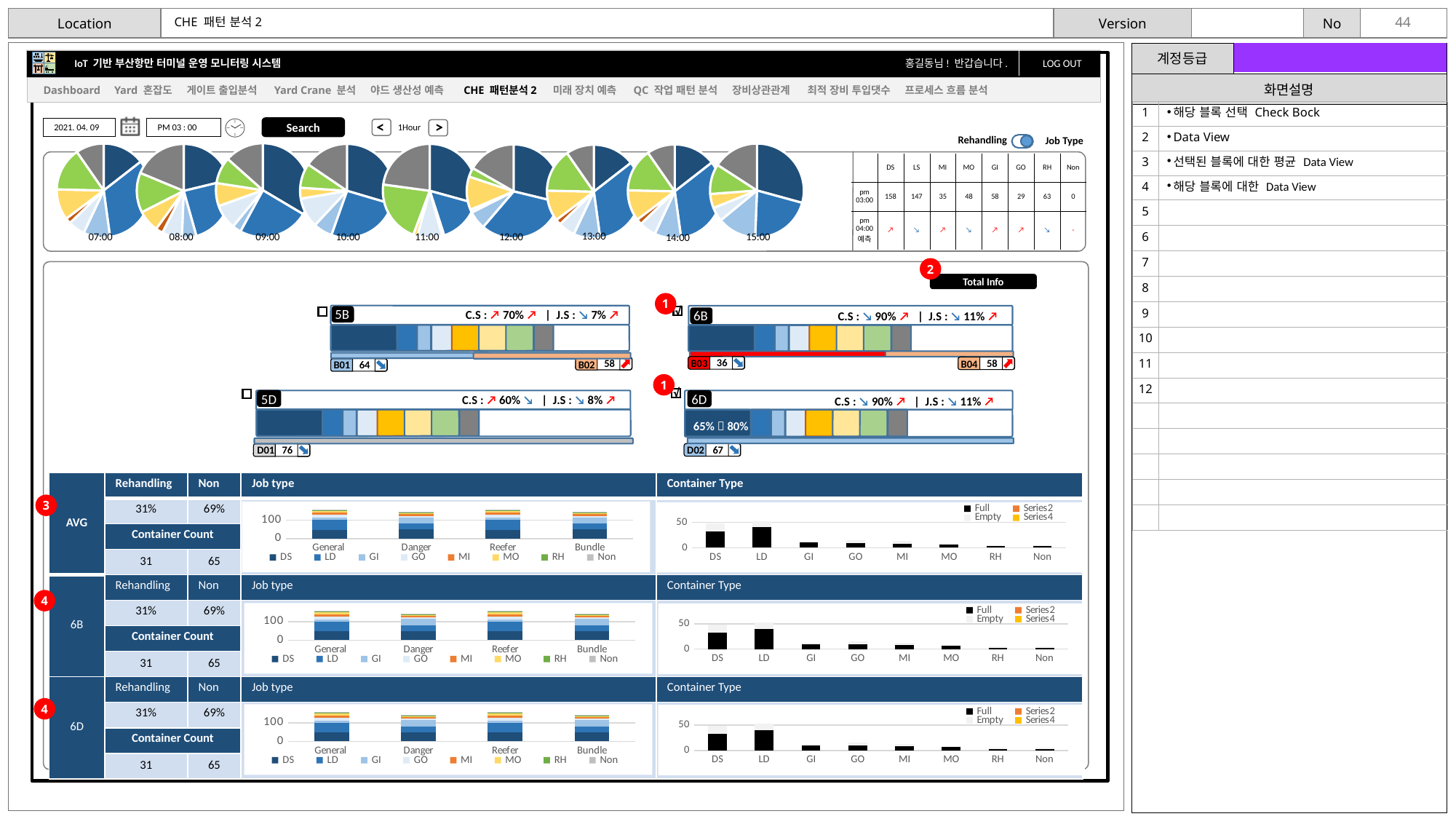
How many categories are shown on the x axis of the Job type chart in the AVG row? 4 What kind of chart is the Container Type chart in the 6B row? bar chart What are the legend entries of the Container Type chart in the 6D row? Full, Empty, Series2, Series4 How many pie charts are shown in the top row of the dashboard? 9 What kind of chart is the Job type chart in the AVG row? bar chart In the Container Type chart in the AVG row, which category has the tallest bar? LD In the Container Type chart in the 6D row, which bar is taller, DS or GI? DS What is the time label under the first pie chart in the top row? 07:00 How many entries does the legend of the Container Type chart in the AVG row list? 4 How many series does the legend of the Job type chart in the AVG row list? 8 How many categories are shown on the x axis of the Container Type chart in the 6B row? 8